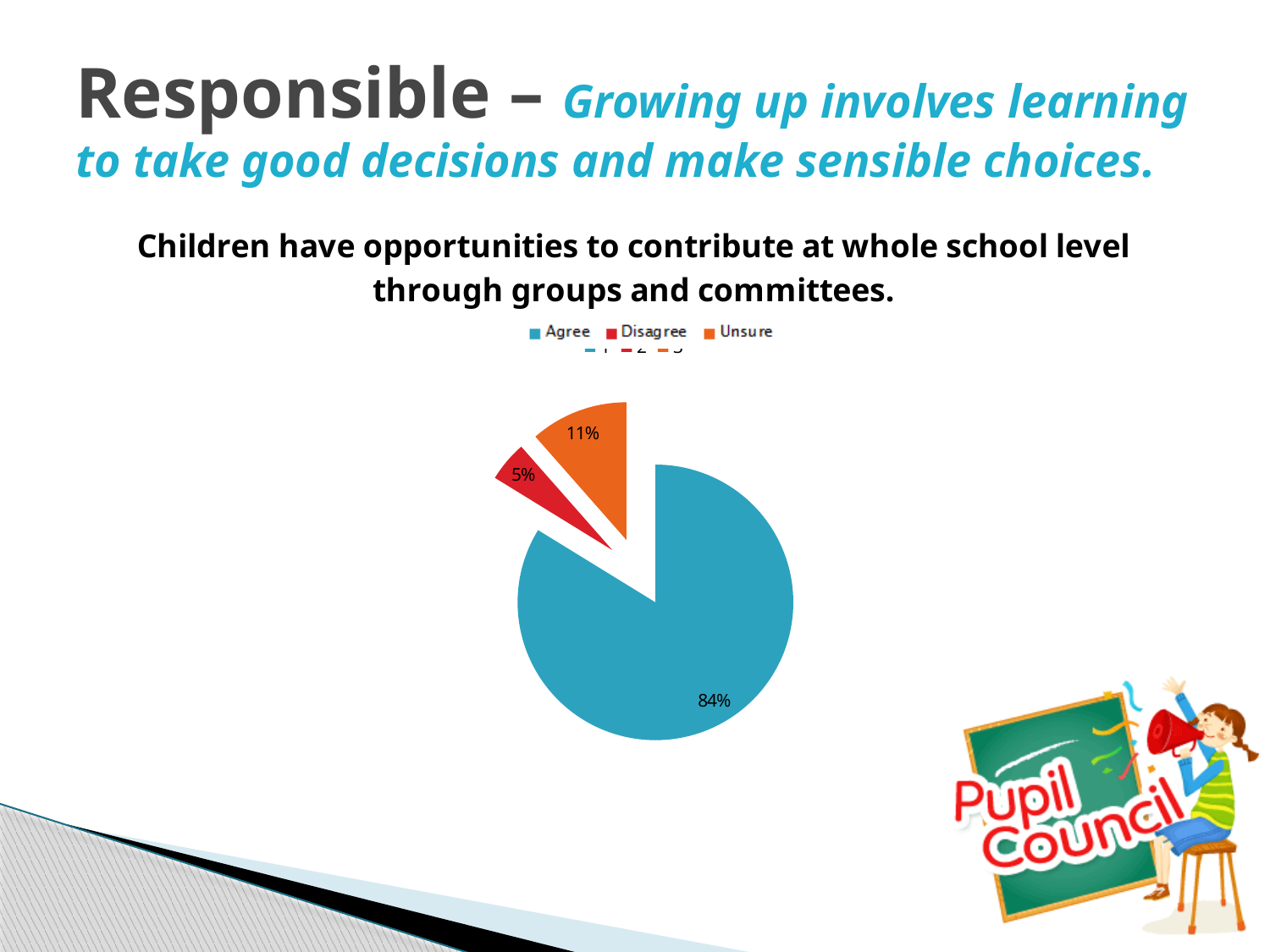
What colour is the Agree slice? Teal/blue Which response has the largest share of the pie? Agree How many slices does the pie chart have? 3 Which is larger, the Unsure share or the Disagree share? Unsure What statement is the pie chart about? Children have opportunities to contribute at whole school level through groups and committees. What type of chart is shown on the slide? Pie chart What percentage of respondents chose Disagree? 5% What percentage of respondents chose Agree? 84% What is the difference in percentage points between Agree and Unsure? 73 What is the difference in percentage points between Unsure and Disagree? 6 What percentage of respondents chose Unsure? 11% Which response has the smallest share of the pie? Disagree